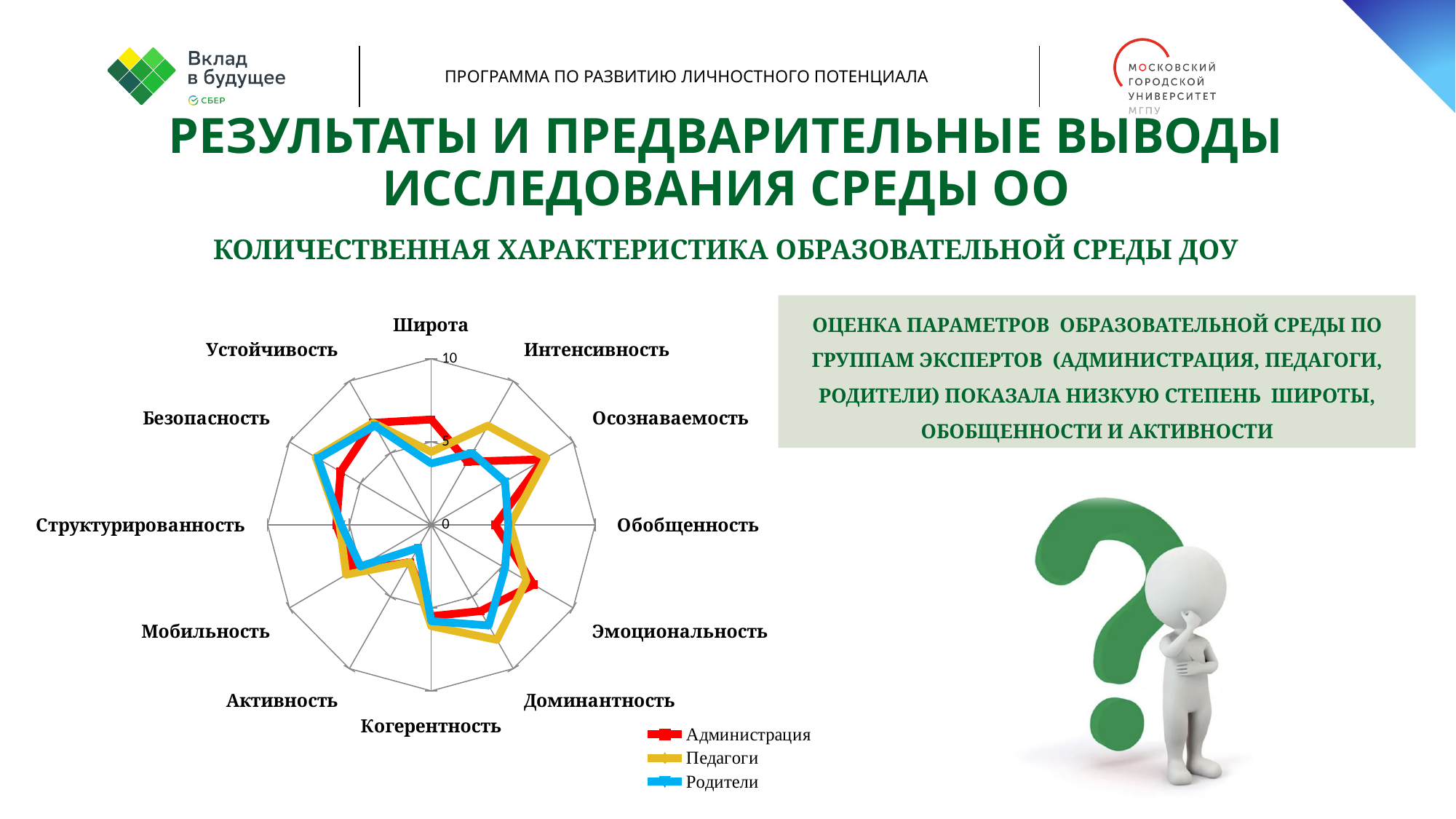
Which series in the radar chart is drawn in red? Администрация Is the value for Эмоциональность for the Администрация series greater or less than 5? greater How many series does the legend of the radar chart list? 3 Is the value for Осознаваемость for the Педагоги series greater or less than 5? greater Is the value for Безопасность for the Родители series greater or less than 5? greater For Осознаваемость, which series has the larger value: Педагоги or Родители? Педагоги How many categories (axes) does the radar chart have? 12 What is the maximum value shown on the radar chart's axis scale? 10 What kind of chart is shown on the slide? radar chart For the Педагоги series, which category has the larger value: Осознаваемость or Активность? Осознаваемость